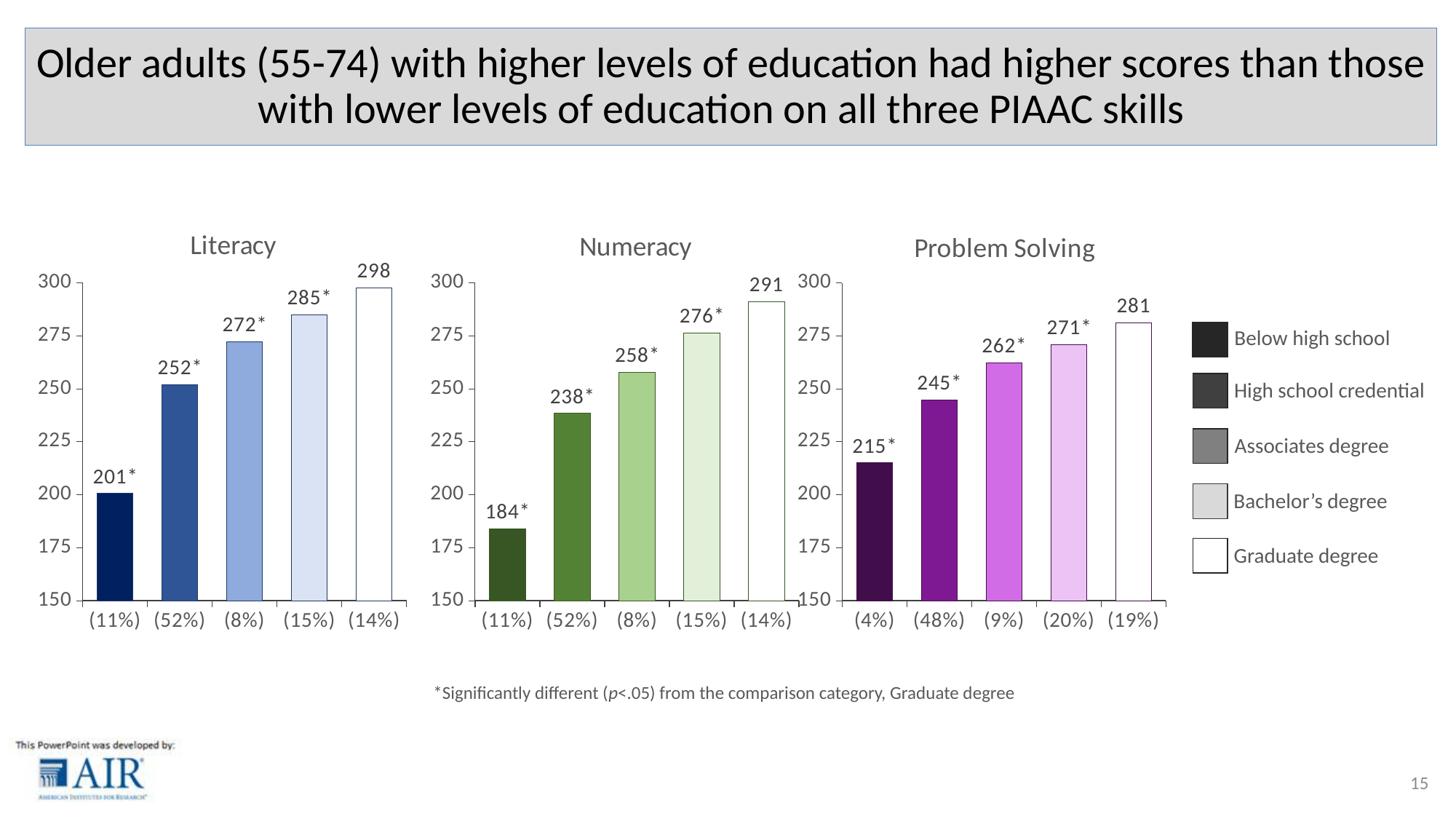
In the Numeracy chart, what is the score for adults with Below high school education? 184 In the Numeracy chart, which education level has the highest score? Graduate degree In the Problem Solving chart, what is the score for adults with a Bachelor's degree? 271 In the Problem Solving chart, what is the difference between the Graduate degree score and the Below high school score? 66 In the Numeracy chart, is the score for High school credential greater or less than 250? less How many education levels does the legend list? 5 What type of chart is used for the Literacy, Numeracy and Problem Solving panels? Bar chart In the Literacy chart, which education level has the lowest score? Below high school In the Literacy chart, what is the score for adults with a Graduate degree? 298 In the Literacy chart, what is the difference between the Associates degree score and the High school credential score? 20 In the Problem Solving chart, do the scores rise or fall as education level increases from Below high school to Graduate degree? Rise Which is larger: the Numeracy score for Associates degree or the Problem Solving score for Associates degree? Problem Solving (262)